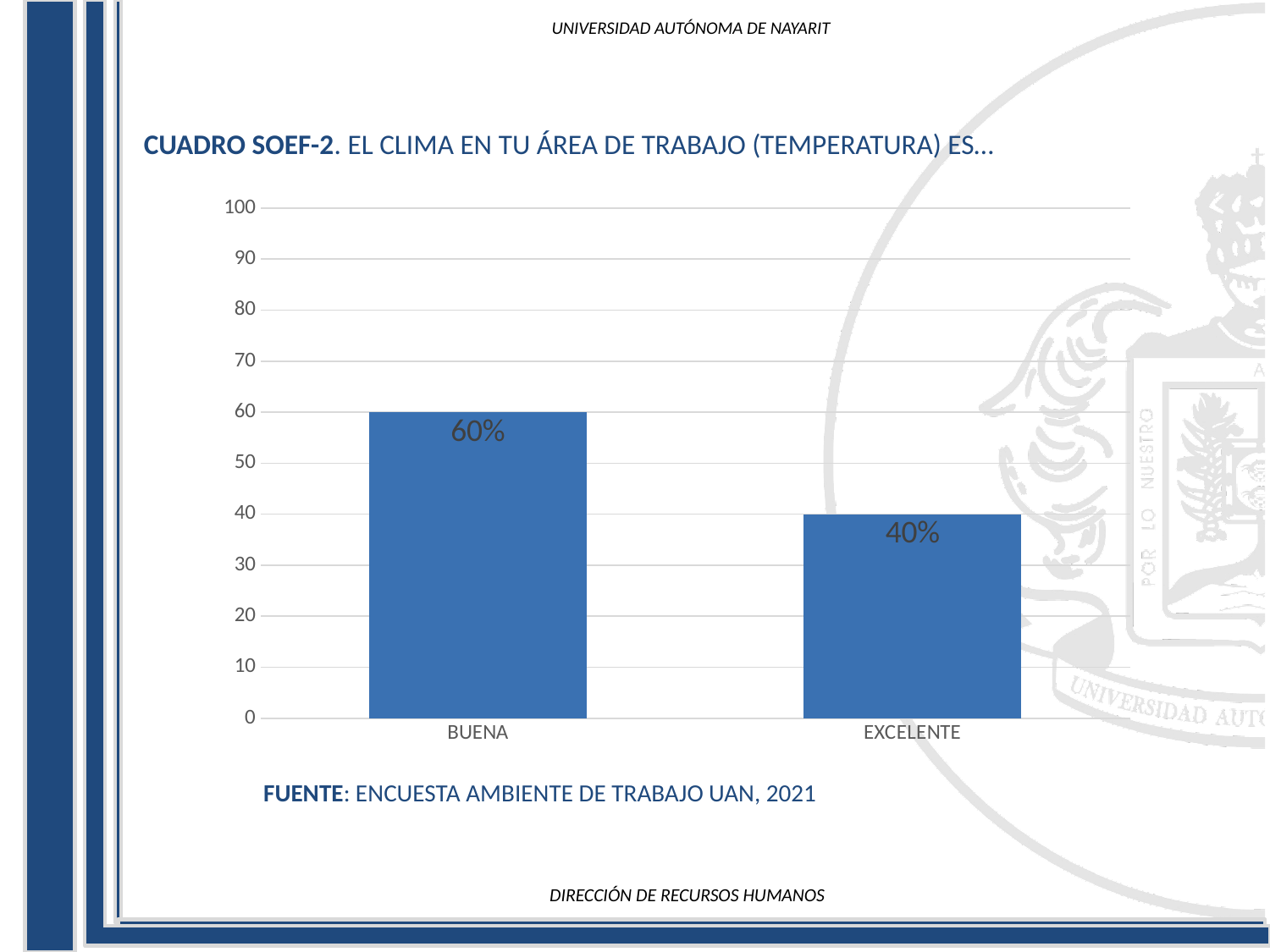
What kind of chart is shown on the slide? bar chart What is the value for BUENA? 60% Is the value for EXCELENTE greater or less than 50? less Which is larger, the value for BUENA or the value for EXCELENTE? BUENA Which category has the highest value? BUENA What is the difference between the values for BUENA and EXCELENTE? 20% Is the value for BUENA greater or less than 50? greater What is the maximum value shown on the vertical axis? 100 What source is cited below the chart? ENCUESTA AMBIENTE DE TRABAJO UAN, 2021 Which category has the lowest value? EXCELENTE How many categories are shown on the x axis? 2 What is the value for EXCELENTE? 40%